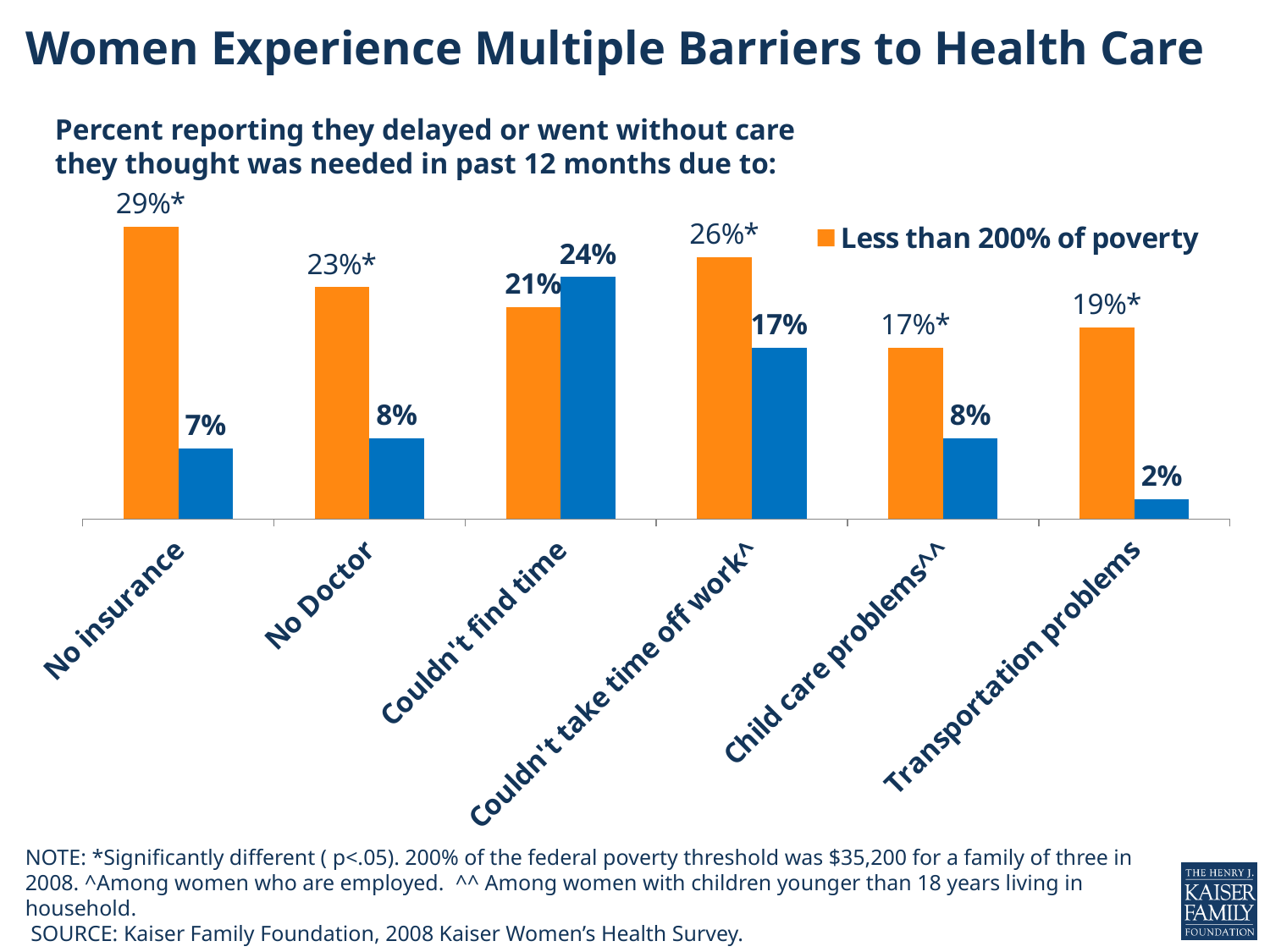
How many categories are shown on the x axis of the chart? 6 What is the value of the orange bar (Less than 200% of poverty) for No insurance? 29%* For Couldn't find time, which bar is larger, the orange bar or the blue bar? the blue bar For Couldn't find time, what is the difference between the blue bar (24%) and the orange bar (21%)? 3 percentage points What series name does the legend list for the orange bars? Less than 200% of poverty What is the value of the blue bar for Couldn't take time off work^? 17% What kind of chart is shown on the slide? bar chart What is the value of the blue bar for Transportation problems? 2% Which category has the highest blue bar? Couldn't find time For No insurance, what is the difference between the orange bar (29%) and the blue bar (7%)? 22 percentage points Which category has the highest orange bar (Less than 200% of poverty)? No insurance Which category has the lowest blue bar? Transportation problems